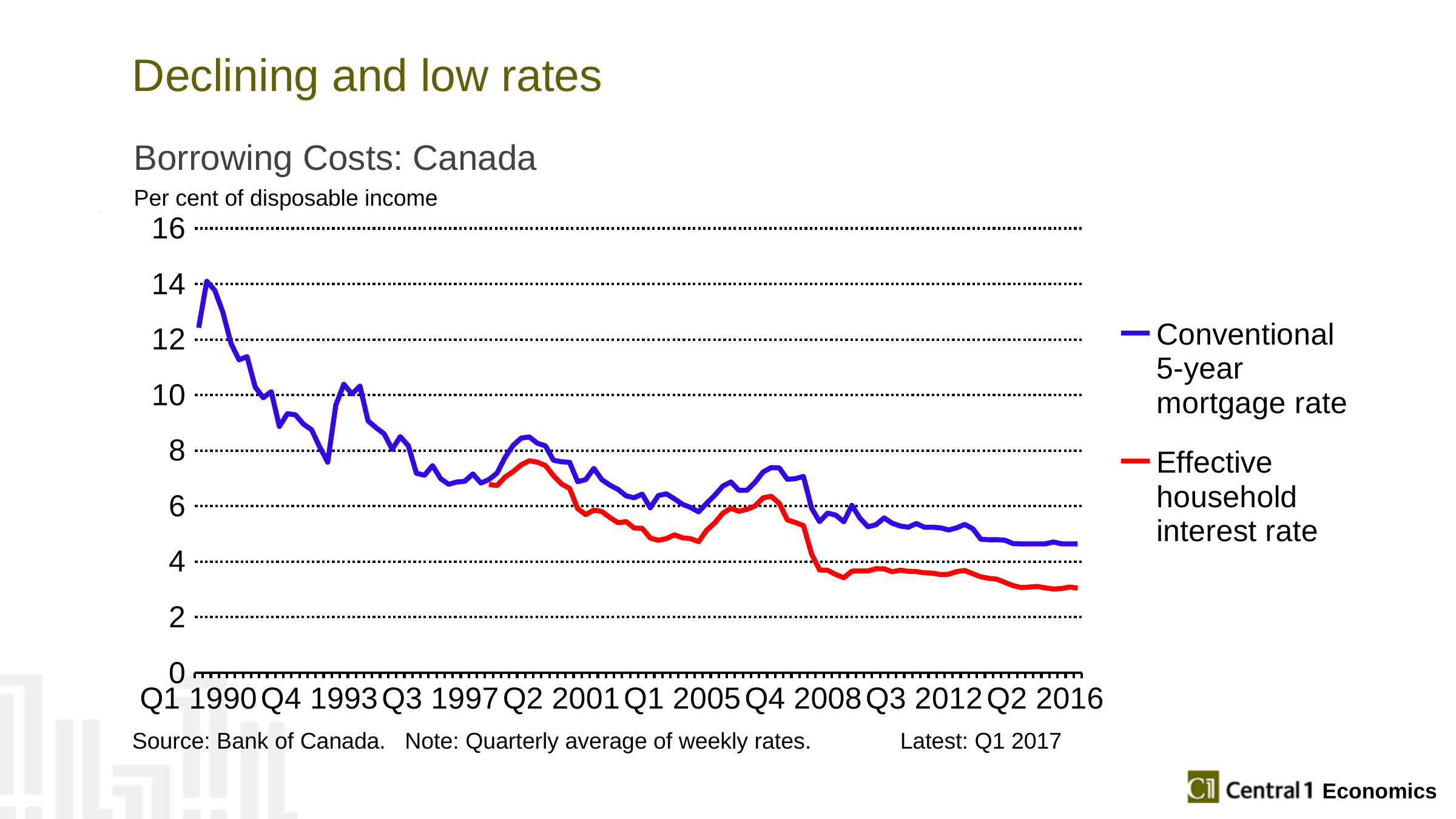
Which series reaches the highest value on the chart? Conventional 5-year mortgage rate Is the value of the Conventional 5-year mortgage rate at Q2 2016 greater or less than 6? less What is the title of the chart? Borrowing Costs: Canada Is the value of the Conventional 5-year mortgage rate at Q4 1993 greater or less than 6? greater Is the value of the Effective household interest rate at Q2 2016 greater or less than 4? less Which series is higher at Q2 2016, the Conventional 5-year mortgage rate or the Effective household interest rate? Conventional 5-year mortgage rate What colour is the line for the Effective household interest rate? Red How many series does the legend list? 2 What kind of chart is shown on the slide? Line chart Do the values of the Conventional 5-year mortgage rate generally rise or fall from Q1 1990 to Q2 2016? Fall